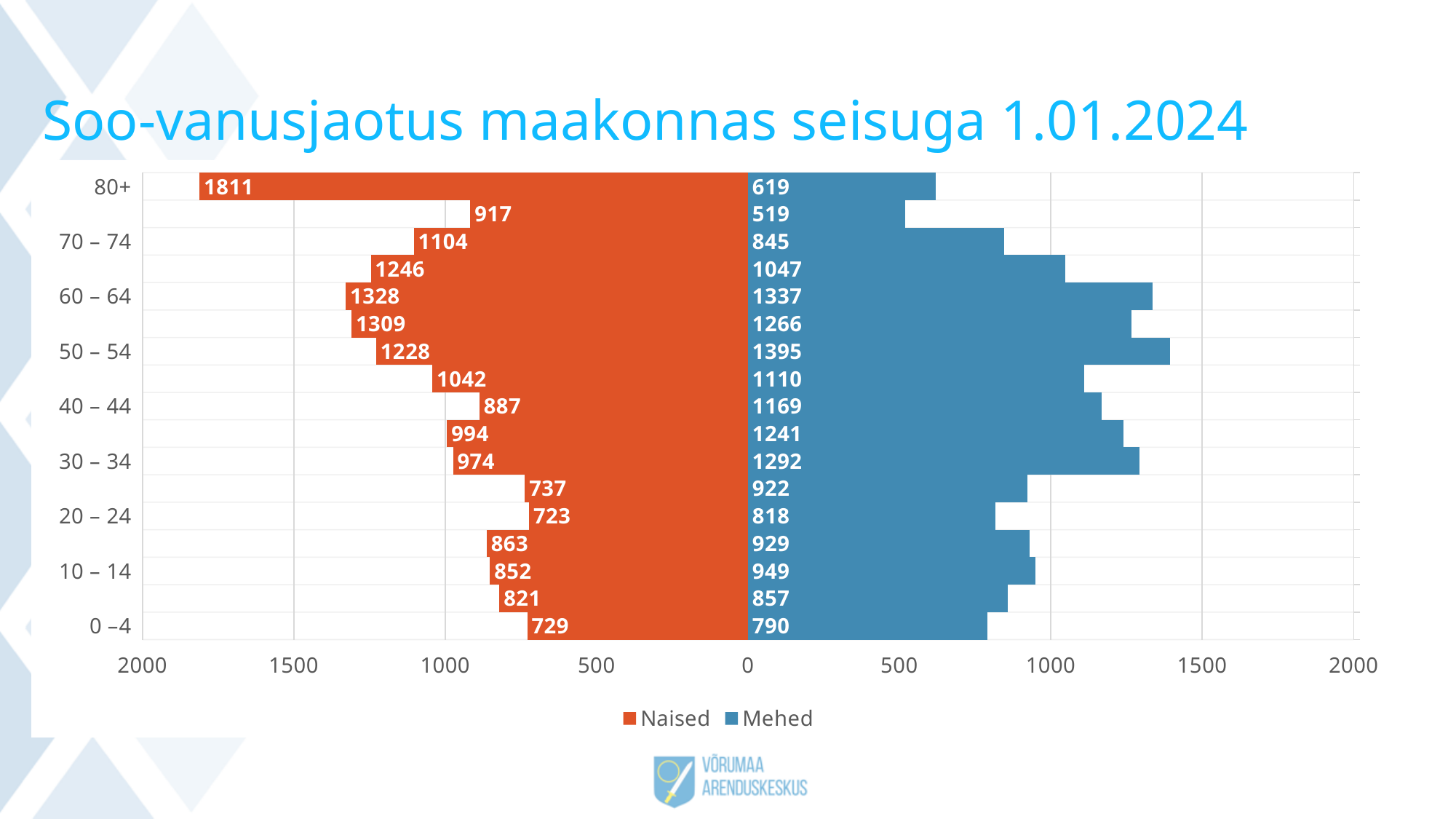
What is the value for Naised in the 80+ age group? 1811 What kind of chart is shown on the slide? Bar chart What is the difference between Mehed and Naised in the 0 – 4 age group? 61 What is the value for Mehed in the 50 – 54 age group? 1395 In the 60 – 64 age group, which is larger, Naised or Mehed? Mehed What is the value for Mehed in the 70 – 74 age group? 845 What is the value for Naised in the 0 – 4 age group? 729 What is the difference between Naised and Mehed in the 80+ age group? 1192 Which age group has the lowest value for Naised? 20 – 24 Which age group has the highest value for Mehed? 50 – 54 How many series does the legend list? 2 Which age group has the highest value for Naised? 80+